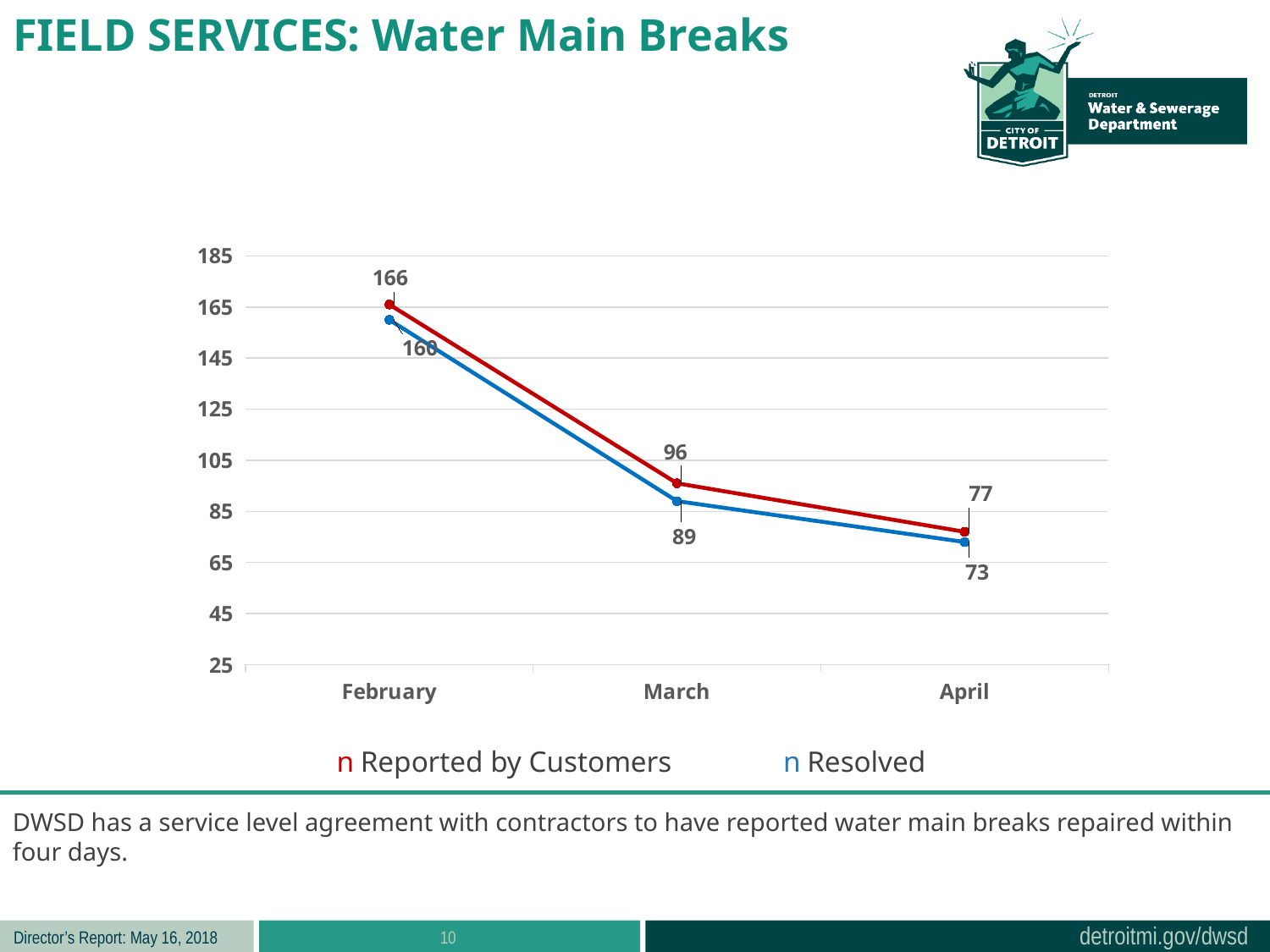
How many series does the legend list? 2 In which month is the Resolved value lowest? April Do the Reported by Customers values rise or fall from February to April? fall What is the value for Reported by Customers in March? 96 In which month is the Reported by Customers value highest? February What is the value for Resolved in April? 73 What is the value for Resolved in March? 89 Which series is drawn in red? Reported by Customers How many months are plotted on the x axis? 3 What is the value for Reported by Customers in February? 166 What is the difference between Reported by Customers and Resolved in April? 4 What kind of chart is shown on the slide? line chart